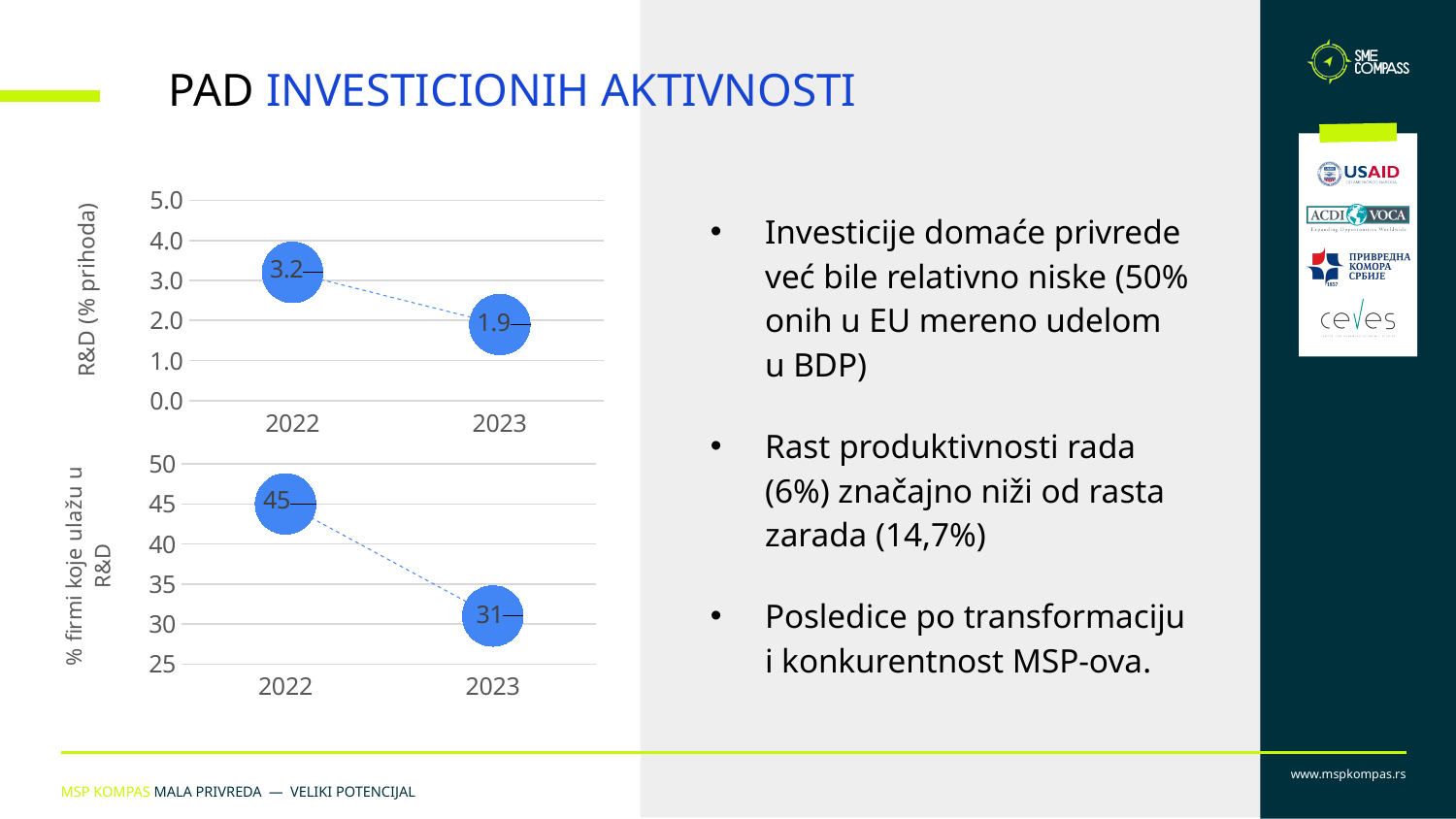
What is the vertical axis title of the top chart? R&D (% prihoda) In the top chart (R&D (% prihoda)), is the value for 2023 greater or less than 2.0? less In the bottom chart (% firmi koje ulažu u R&D), do the values rise or fall from 2022 to 2023? fall In the bottom chart (% firmi koje ulažu u R&D), what is the value for 2022? 45 In the top chart (R&D (% prihoda)), what is the value for 2022? 3.2 How many years are plotted in the bottom chart (% firmi koje ulažu u R&D)? 2 In the bottom chart (% firmi koje ulažu u R&D), what is the difference between the 2022 and 2023 values? 14 In the bottom chart (% firmi koje ulažu u R&D), what is the value for 2023? 31 In the bottom chart (% firmi koje ulažu u R&D), which year has the lower value? 2023 In the top chart (R&D (% prihoda)), which year has the higher value? 2022 In the top chart (R&D (% prihoda)), what is the value for 2023? 1.9 In the top chart (R&D (% prihoda)), by how much did the value fall from 2022 to 2023? 1.3